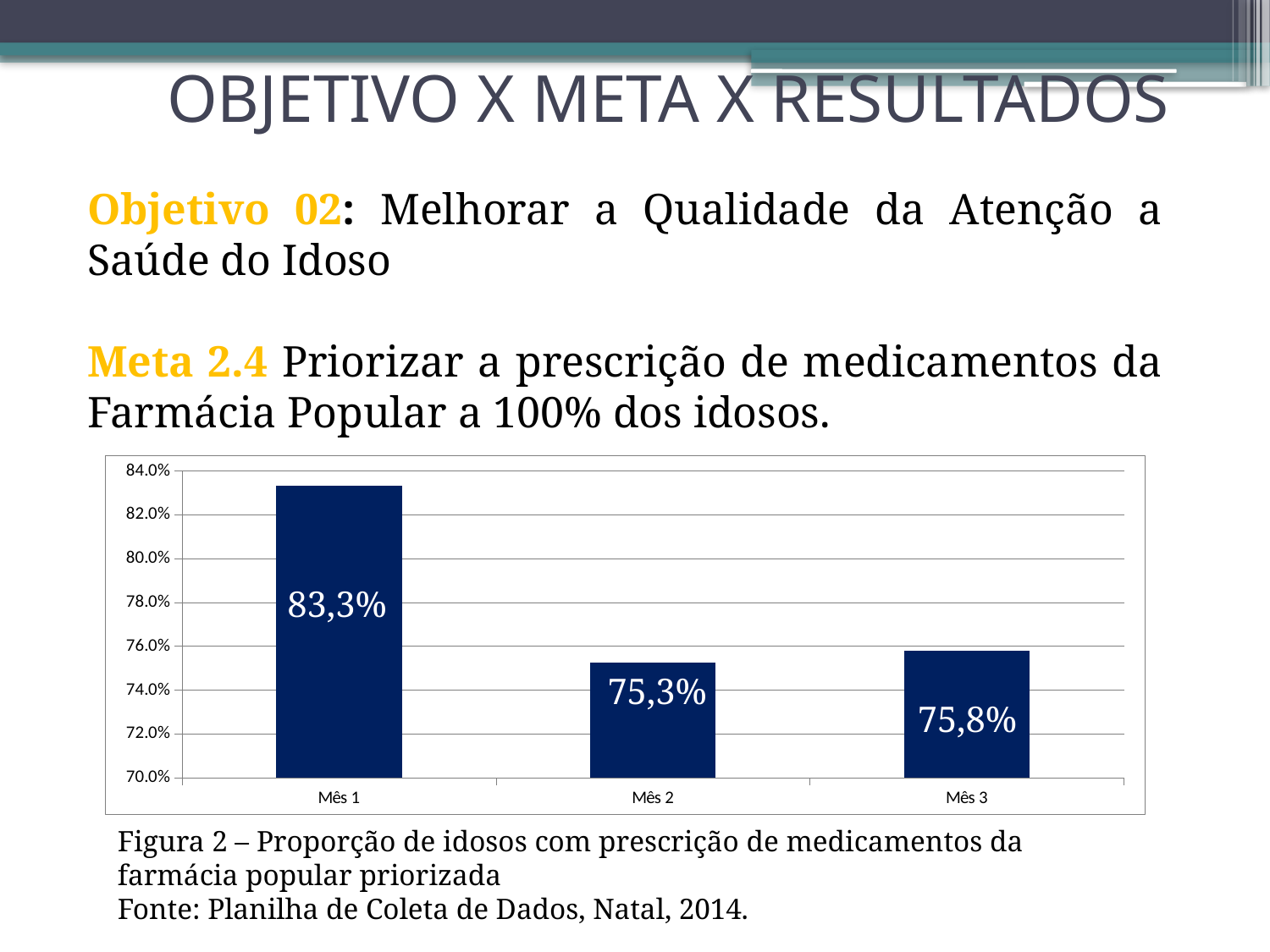
Which month has the lowest value? Mês 2 Is the value for Mês 2 greater or less than 76.0%? less What is the value for Mês 3? 75,8% What is the difference between the values for Mês 1 and Mês 2? 8,0% Which is larger, the value for Mês 1 or the value for Mês 3? Mês 1 Is the value for Mês 1 greater or less than 80.0%? greater Which month has the highest value? Mês 1 What is the difference between the values for Mês 3 and Mês 2? 0,5% What kind of chart is shown on the slide? Bar chart What is the value for Mês 2? 75,3% How many months are shown on the x axis of the chart? 3 What is the value for Mês 1? 83,3%